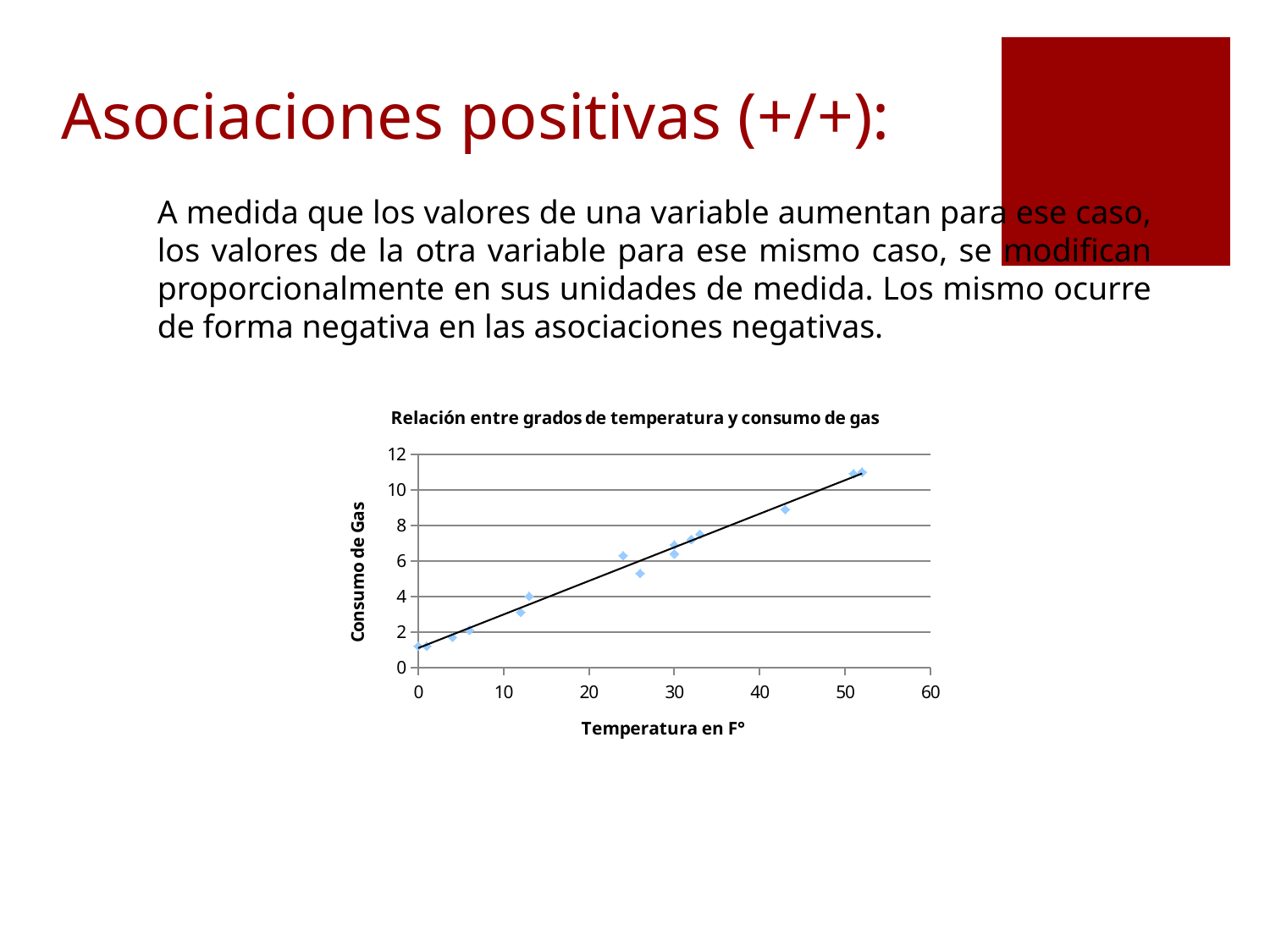
Is the gas consumption for the point at a temperature of about 26 F° greater or less than 6? less Is the gas consumption for the point at a temperature of about 43 F° greater or less than 8? greater What is the label of the horizontal axis of the chart? Temperatura en F° As temperature increases along the x axis, does gas consumption rise or fall? Rise Is the gas consumption for the point at a temperature of about 13 F° greater or less than 6? less What is the title of the chart? Relación entre grados de temperatura y consumo de gas What kind of chart is shown on the slide? Scatter chart Which has the higher gas consumption: the point at about 43 F° or the point at about 26 F°? The point at about 43 F°